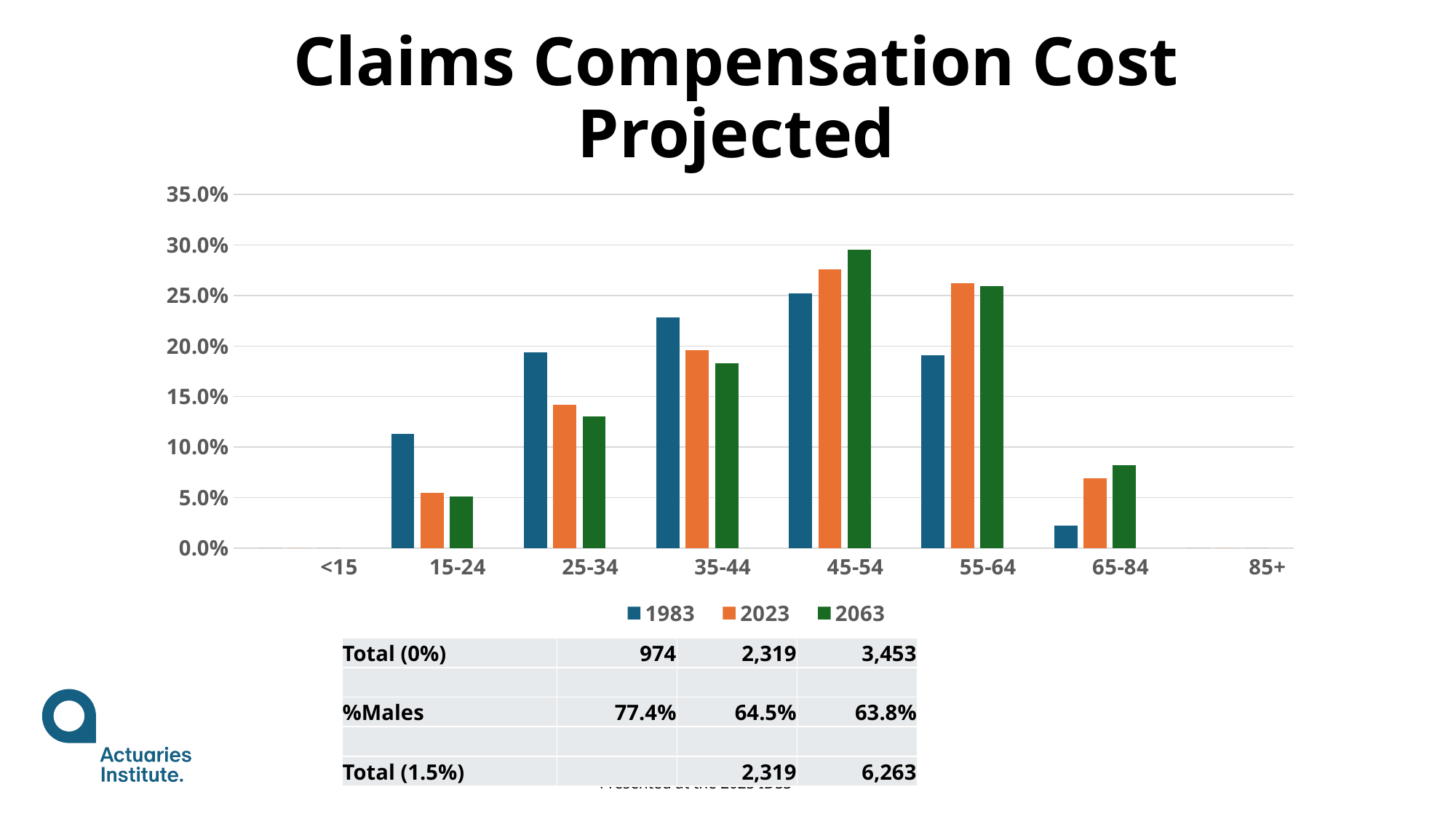
Is the value for 1983 in the 35-44 category greater or less than 20.0%? greater Is the value for 2063 in the 45-54 category greater or less than 25.0%? greater Which age category has the highest value for the 2063 series? 45-54 What are the three series listed in the legend? 1983, 2023, 2063 In the 15-24 category, which series has the larger value, 1983 or 2023? 1983 How many age categories are shown on the x axis? 8 In the 45-54 category, which series has the larger value, 1983 or 2063? 2063 What kind of chart is shown on the slide? bar chart Is the value for 2023 in the 15-24 category greater or less than 10.0%? less How many series does the legend list? 3 Which age category has the highest value for the 1983 series? 45-54 In the 65-84 category, which series has the larger value, 1983 or 2063? 2063